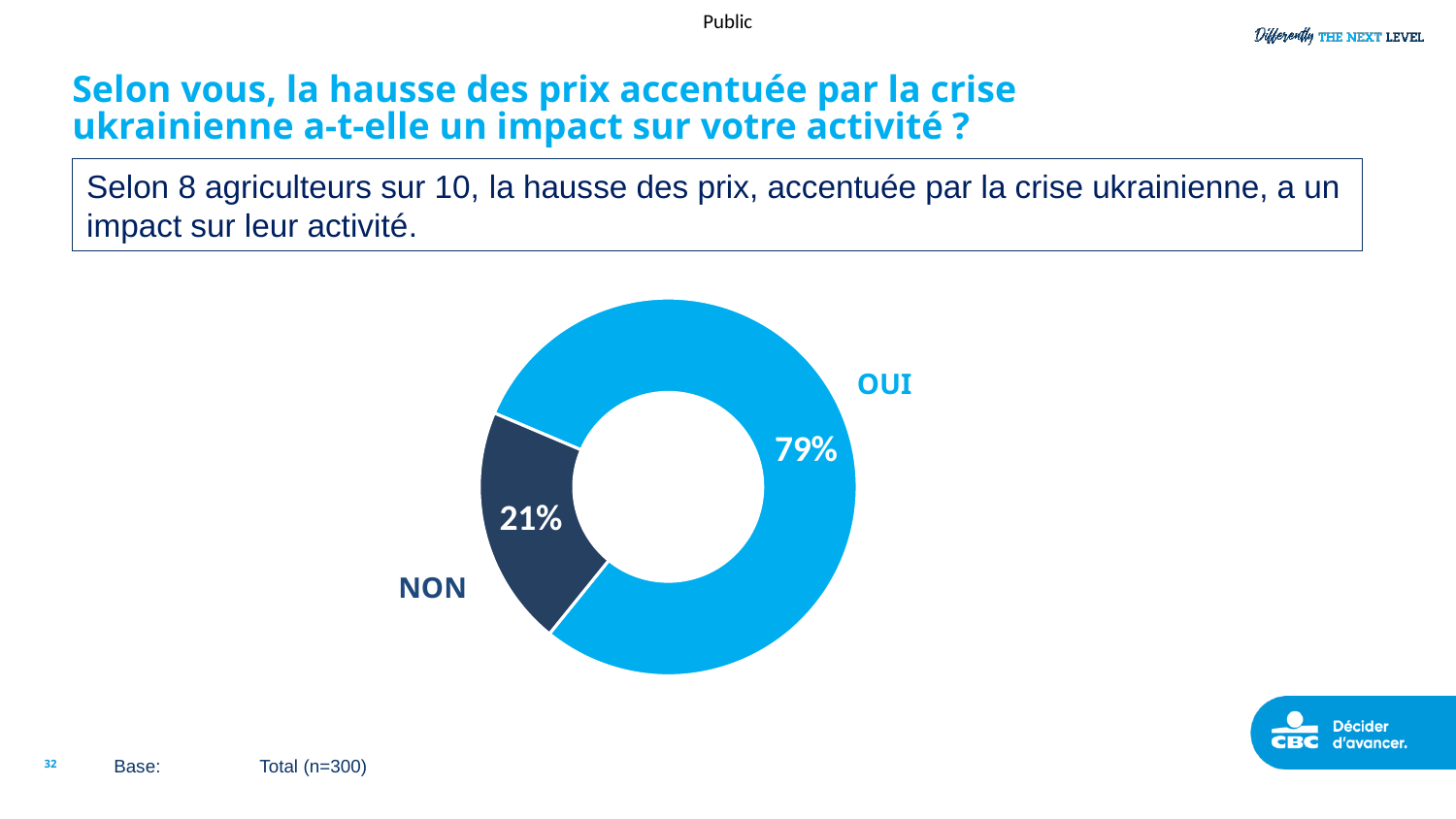
What kind of chart is shown on the slide? Pie chart (donut) What share of the pie does the NON slice represent? 21% What colour is the OUI slice of the chart? Light blue What percentage of respondents answered OUI? 79% Which response has the smallest share of the chart? NON Which response has the largest share of the chart? OUI What percentage of respondents answered NON? 21% Which is larger, the share for OUI or the share for NON? OUI What is the base (sample size) indicated for the chart? Total (n=300) How many categories are shown in the chart? 2 What is the total of the two slices shown in the chart? 100% What is the difference in percentage points between the OUI and NON shares? 58